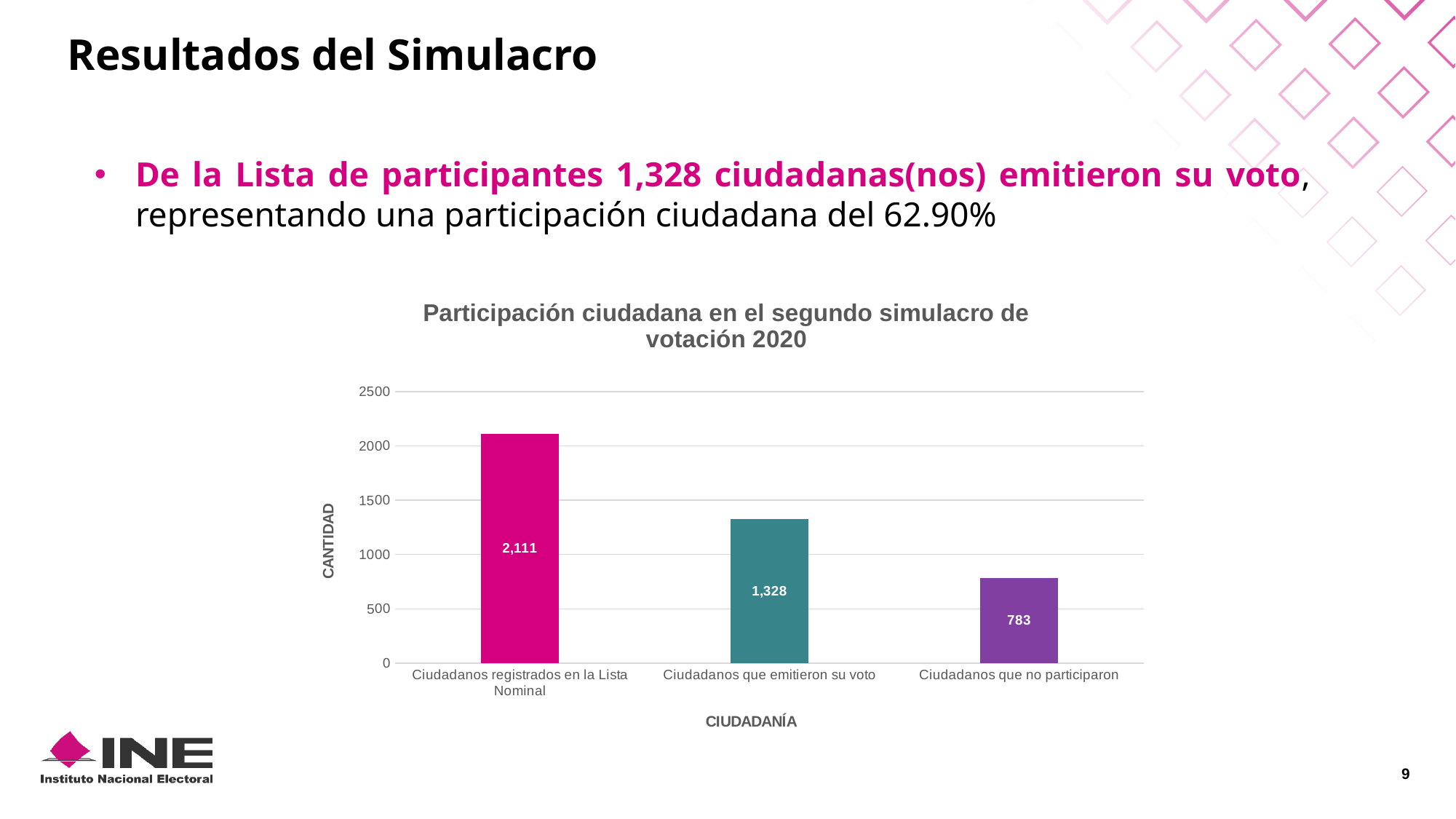
What is the value for Ciudadanos que no participaron? 783 Which category has the lowest value? Ciudadanos que no participaron What is the title of the chart? Participación ciudadana en el segundo simulacro de votación 2020 What is the value for Ciudadanos que emitieron su voto? 1,328 Which category has the highest value? Ciudadanos registrados en la Lista Nominal What is the difference between Ciudadanos que emitieron su voto and Ciudadanos que no participaron? 545 What kind of chart is shown on the slide? bar chart How many categories are shown in the chart? 3 Is the value for Ciudadanos que no participaron greater or less than 1000? less What is the difference between Ciudadanos registrados en la Lista Nominal and Ciudadanos que emitieron su voto? 783 Which is larger, Ciudadanos que emitieron su voto or Ciudadanos que no participaron? Ciudadanos que emitieron su voto What is the value for Ciudadanos registrados en la Lista Nominal? 2,111